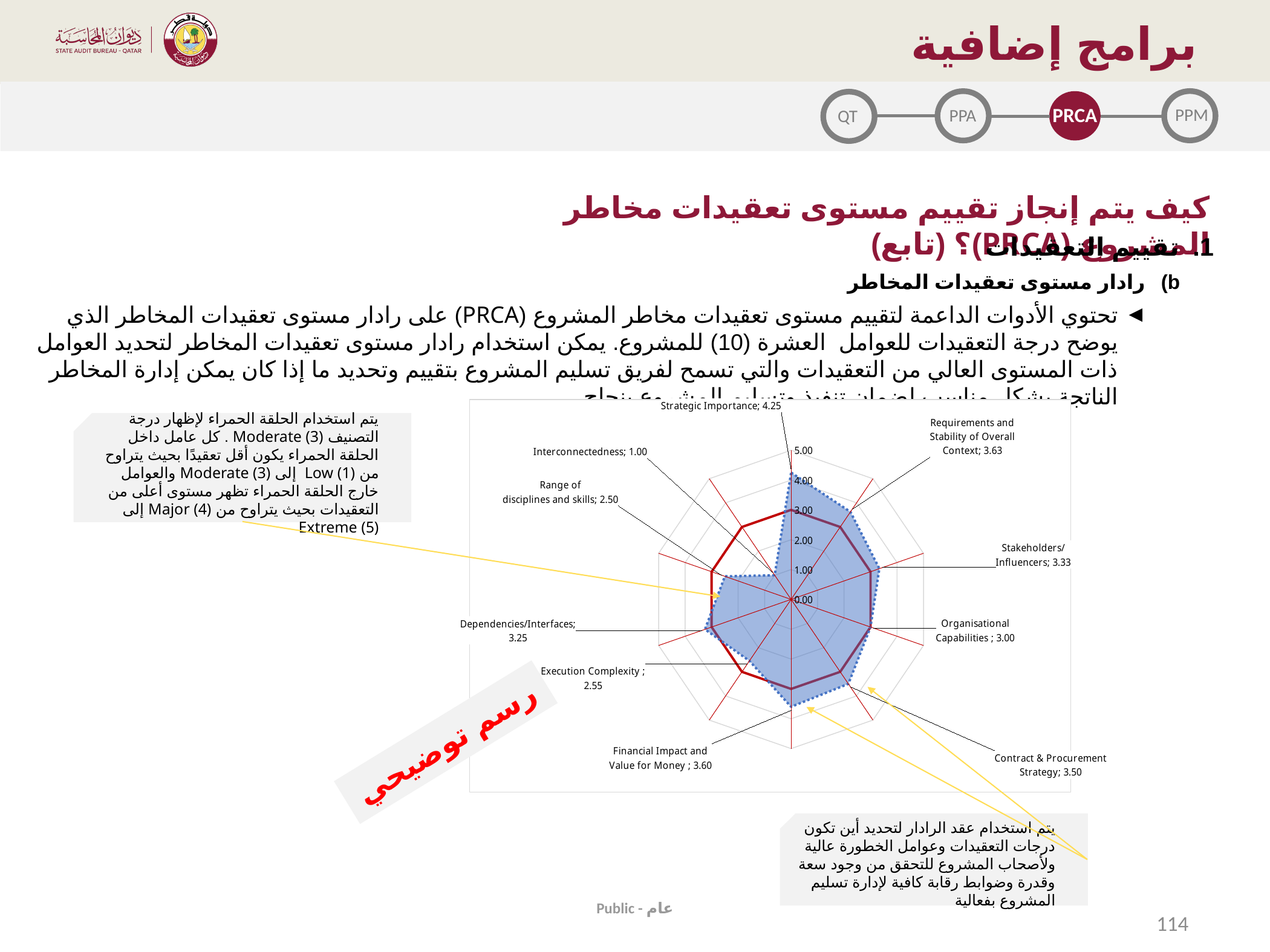
Which factor has the lowest value on the radar chart? Interconnectedness What is the value for Interconnectedness on the radar chart? 1.00 How many factors (categories) are plotted on the radar chart? 10 What is the value for Contract & Procurement Strategy on the radar chart? 3.50 What is the value for Execution Complexity on the radar chart? 2.55 What is the value for Strategic Importance on the radar chart? 4.25 What is the difference between the values for Strategic Importance and Interconnectedness? 3.25 Which has a larger value: Financial Impact and Value for Money or Dependencies/Interfaces? Financial Impact and Value for Money Is the value for Range of disciplines and skills greater or less than 3.00? less Which factor has the highest value on the radar chart? Strategic Importance What type of chart is shown on the slide? Radar chart What is the maximum value shown on the radar chart's axis scale? 5.00